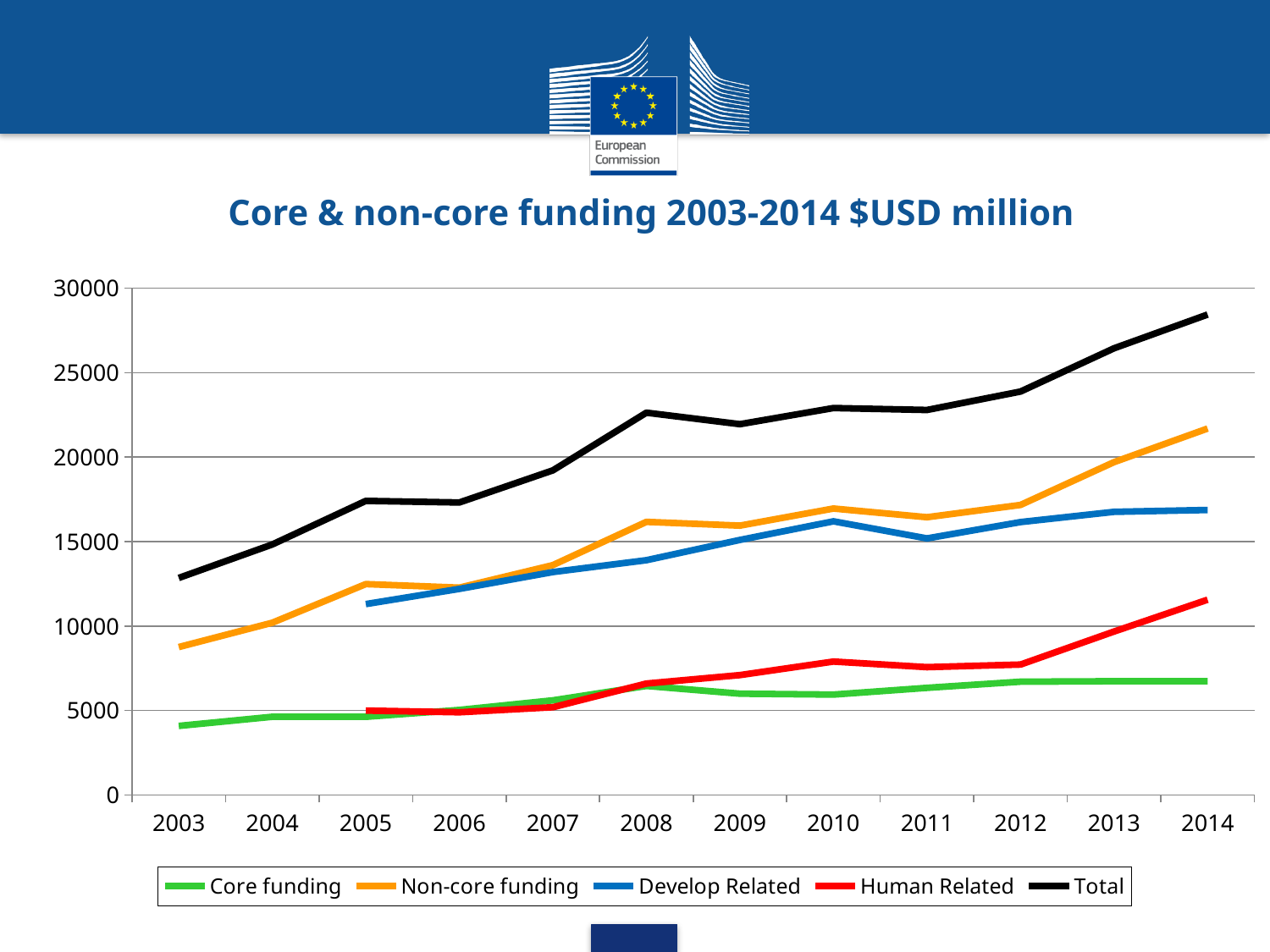
In 2010, which is larger: Human Related or Core funding? Human Related Is the value for Total in 2014 greater or less than 25000? greater Is the value for Non-core funding in 2014 greater or less than 20000? greater Is the value for Total in 2003 greater or less than 15000? less In which year is the Total series at its highest? 2014 What kind of chart is shown on the slide? line chart Which series has the lowest value in 2014? Core funding How many years are shown on the x axis? 12 How many series does the legend list? 5 Does the Total series rise or fall overall from 2003 to 2014? rise